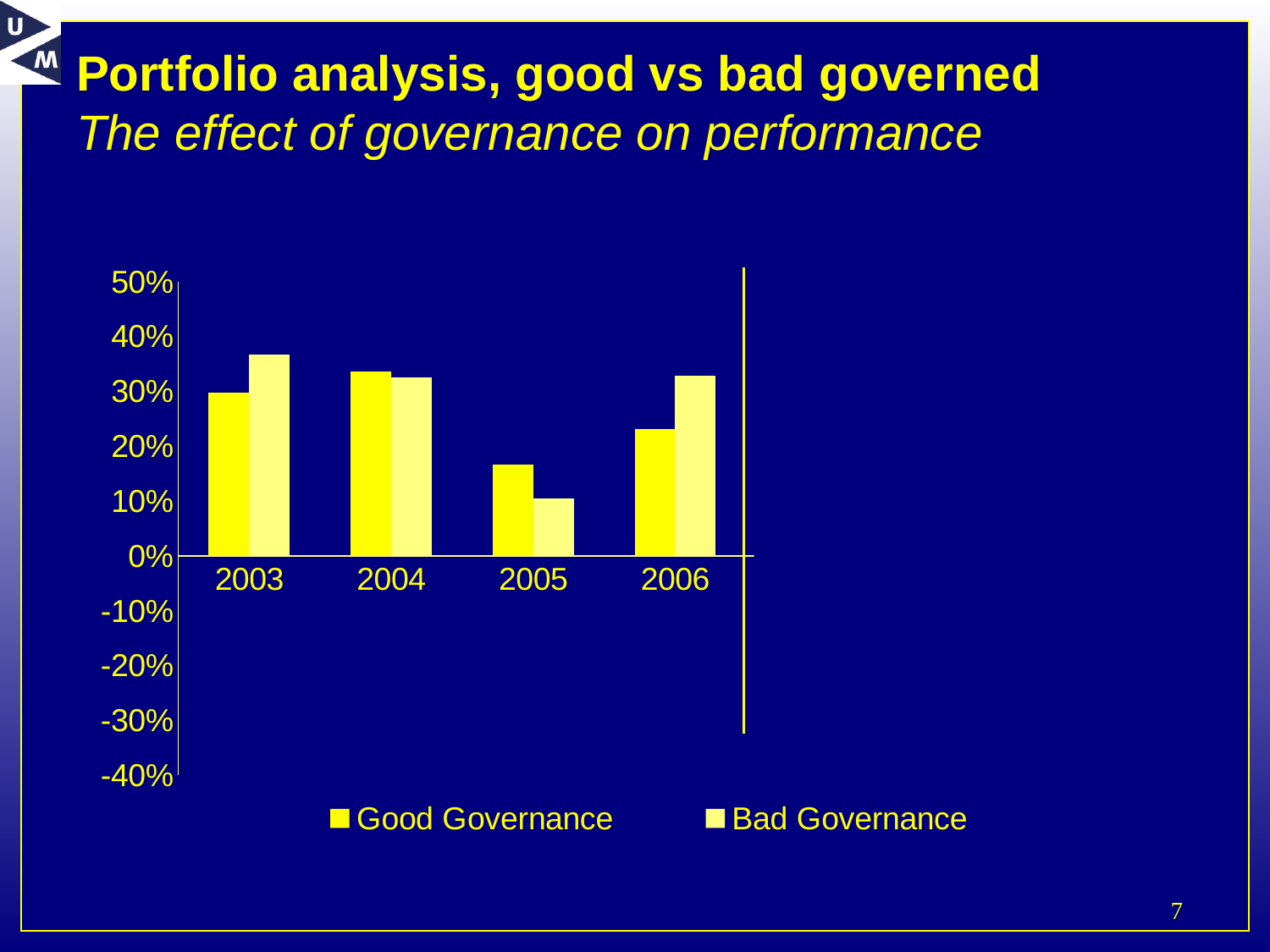
Which year has the lowest Bad Governance value? 2005 In 2003, which is larger: Good Governance or Bad Governance? Bad Governance How many years are shown on the x axis? 4 Which year has the lowest Good Governance value? 2005 Is the Good Governance value for 2003 greater or less than 20%? greater What are the two legend entries of the chart? Good Governance and Bad Governance What kind of chart is shown on the slide? bar chart Is the Bad Governance value for 2005 greater or less than 20%? less In 2005, which is larger: Good Governance or Bad Governance? Good Governance Which year has the highest Bad Governance value? 2003 Do the Bad Governance values rise or fall from 2003 to 2005? fall How many series does the legend list? 2